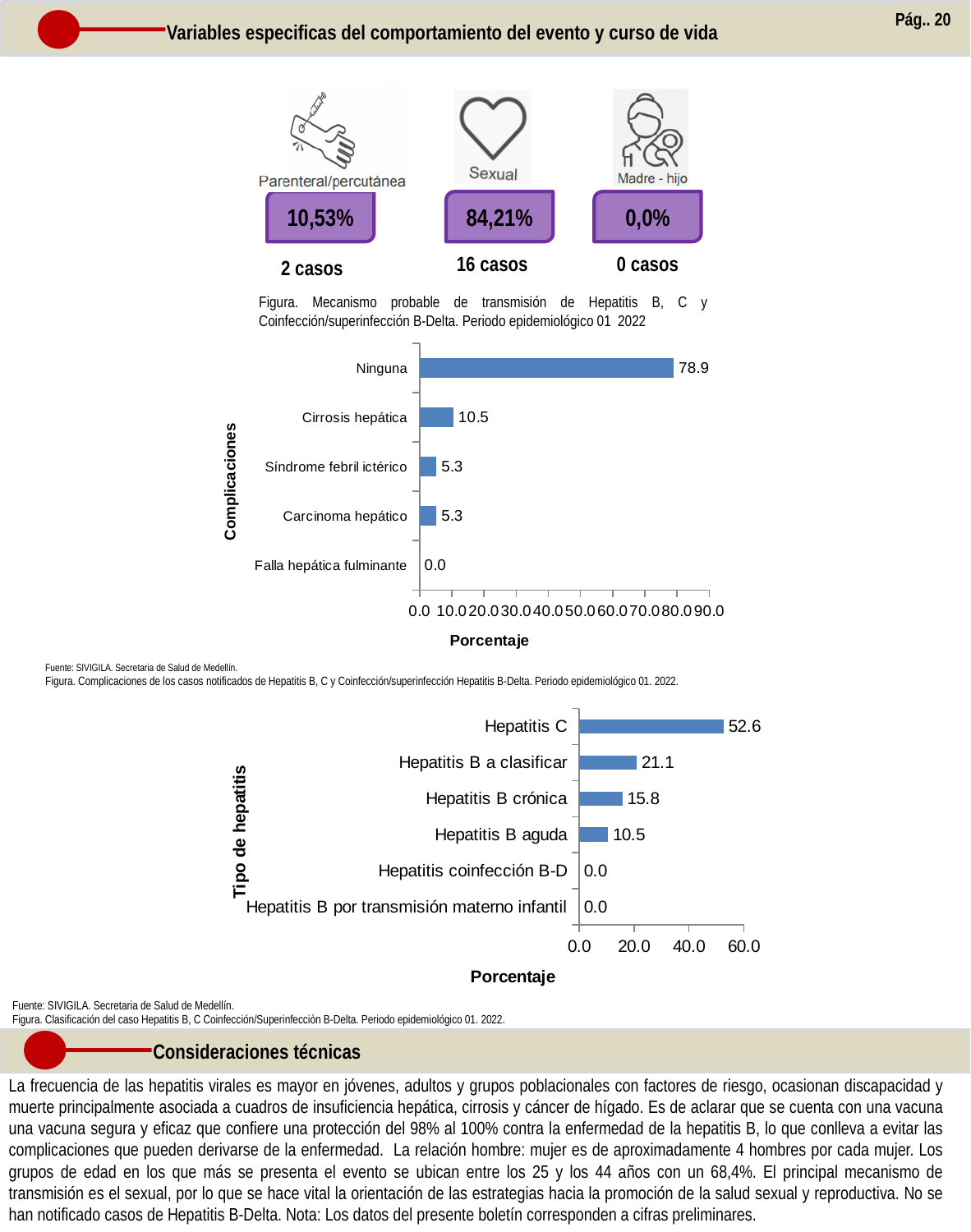
In the lower bar chart (Tipo de hepatitis), what is the value for Hepatitis C? 52.6 In the lower bar chart (Tipo de hepatitis), how many categories are shown? 6 In the lower bar chart (Tipo de hepatitis), which is larger, Hepatitis B a clasificar or Hepatitis B aguda? Hepatitis B a clasificar In the upper bar chart (Complicaciones), how many categories are shown? 5 In the upper bar chart (Complicaciones), which category has the lowest value? Falla hepática fulminante In the upper bar chart (Complicaciones), what is the value for Cirrosis hepática? 10.5 In the upper bar chart (Complicaciones), what is the value for Ninguna? 78.9 In the upper bar chart (Complicaciones), which category has the highest value? Ninguna In the lower bar chart (Tipo de hepatitis), what is the value for Hepatitis B crónica? 15.8 In the upper bar chart (Complicaciones), what is the difference between the values for Ninguna and Cirrosis hepática? 68.4 What type of chart is the lower chart (Tipo de hepatitis)? Bar chart In the lower bar chart (Tipo de hepatitis), what is the difference between the values for Hepatitis C and Hepatitis B a clasificar? 31.5